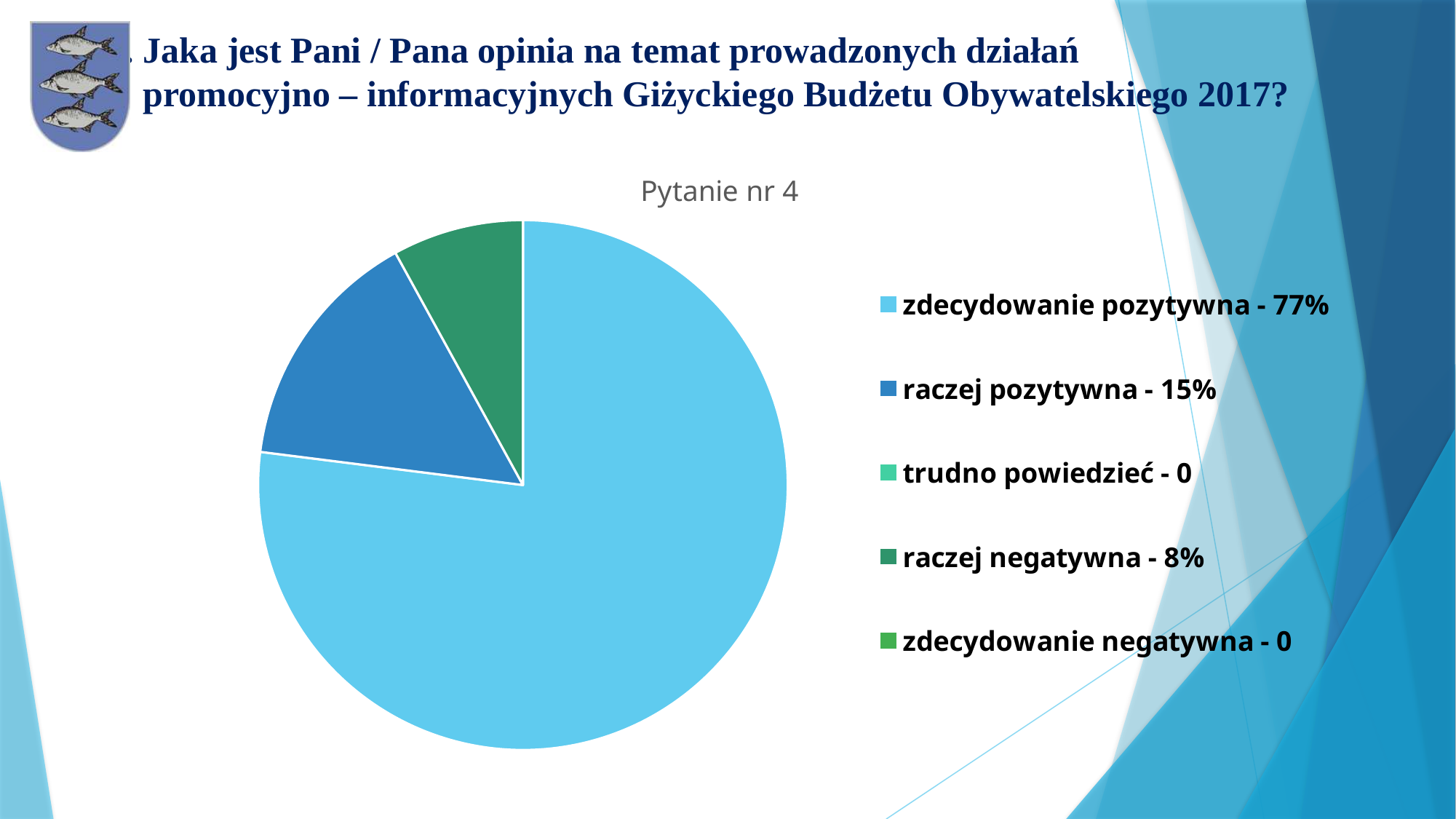
What percentage is shown for "zdecydowanie pozytywna"? 77% What percentage is shown for "raczej pozytywna"? 15% What percentage is shown for "raczej negatywna"? 8% What is the difference between the shares of "zdecydowanie pozytywna" and "raczej pozytywna"? 62% What is the combined share of "zdecydowanie pozytywna" and "raczej pozytywna"? 92% Which legend entry is shown in dark green? raczej negatywna - 8% What kind of chart is shown on the slide? pie chart What value is shown for "trudno powiedzieć"? 0 Which is larger, the share for "raczej pozytywna" or the share for "raczej negatywna"? raczej pozytywna Which category has the largest share of the pie? zdecydowanie pozytywna What is the title of the chart? Pytanie nr 4 How many categories does the legend list? 5